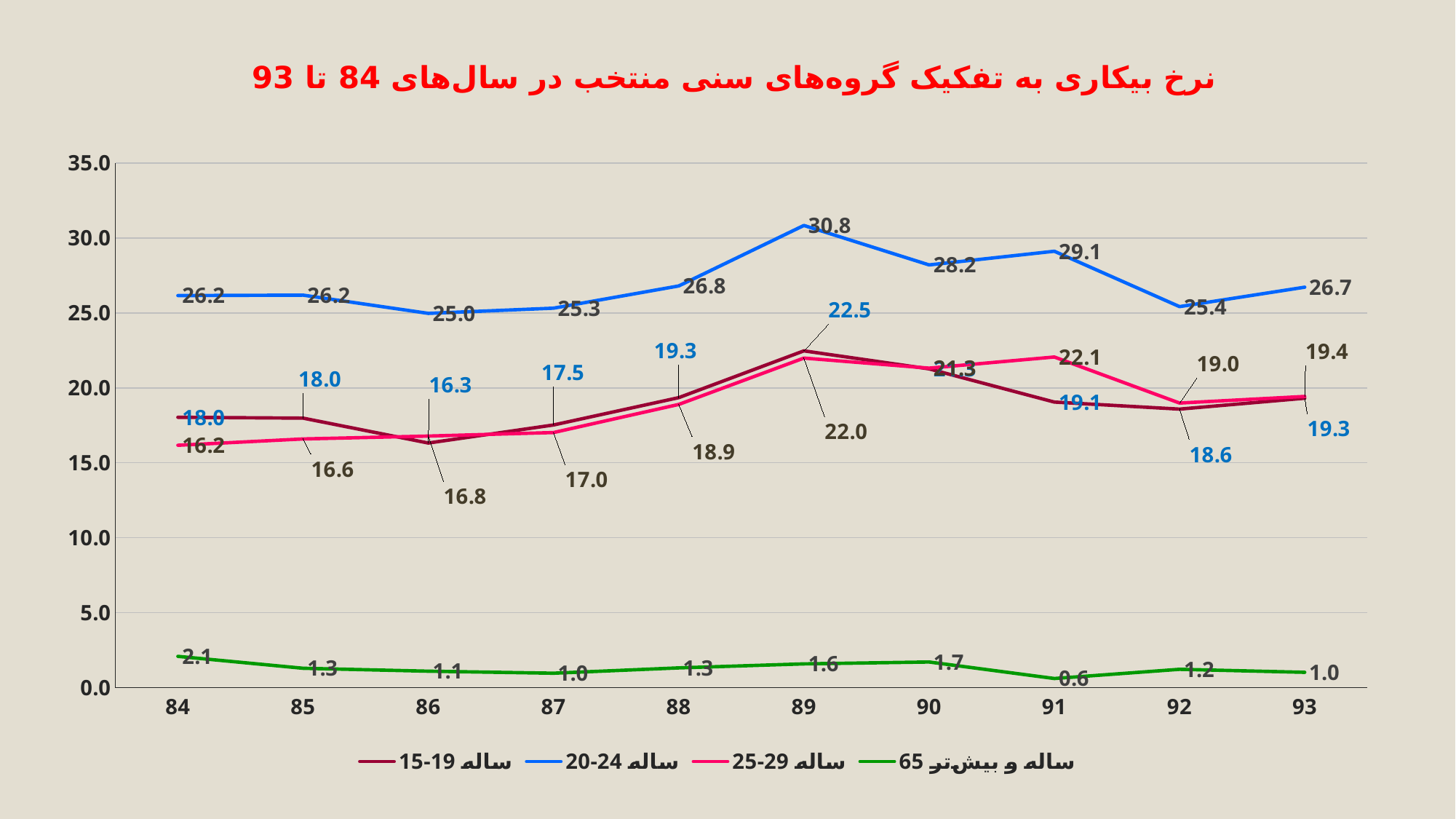
Is the value for the 20-24 ساله series in year 89 greater or less than 30? greater What is the value for the 20-24 ساله series in year 89? 30.8 What is the difference between the 20-24 ساله values in year 89 and year 84? 4.6 Does the 20-24 ساله series rise or fall from year 91 to year 92? fall How many years are shown along the x axis? 10 How many series does the legend list? 4 In which year does the 65 ساله و بیشتر series reach its lowest value? 91 What kind of chart is shown on the slide? line chart Which series has the larger value in year 91: 20-24 ساله or 65 ساله و بیشتر? 20-24 ساله What is the value for the 20-24 ساله series in year 92? 25.4 What is the value for the 65 ساله و بیشتر series in year 84? 2.1 In which year does the 20-24 ساله series reach its highest value? 89